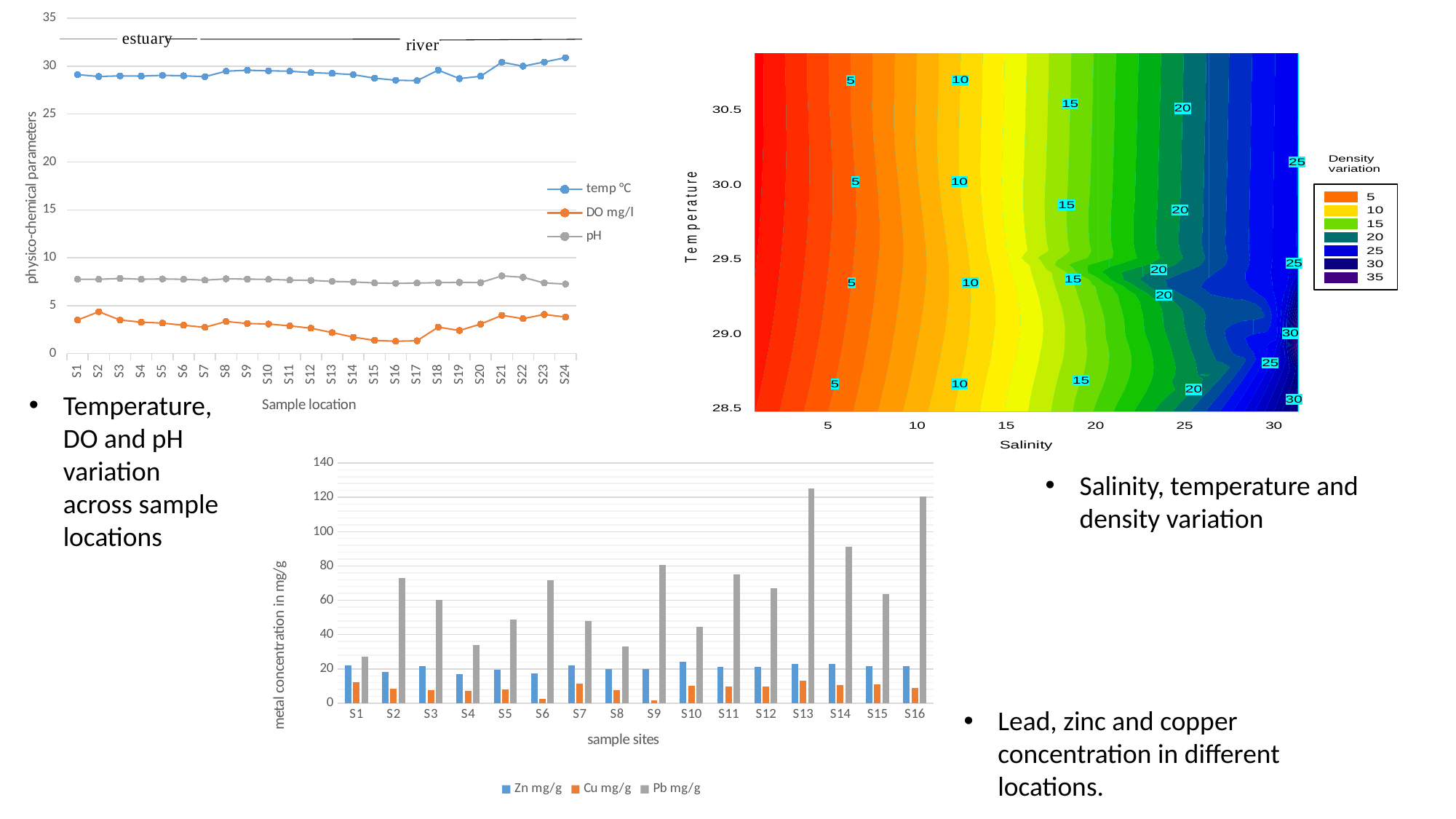
In the top-left line chart, how many sample locations are shown on the x axis? 24 In the top-left line chart, how many series does the legend list? 3 In the top-left line chart, is the temp °C value at S24 greater or less than 30? greater In the top-left line chart, is the DO mg/l value at S16 greater or less than 5? less What kind of chart is the top-left chart showing temperature, DO and pH across sample locations? line chart In the bottom bar chart, which sample site has the lowest Pb mg/g value? S1 What kind of chart is the bottom chart showing metal concentration in mg/g at sample sites? bar chart In the bottom bar chart, which is larger, the Pb mg/g value at S9 or at S10? S9 In the top-left line chart, does the DO mg/l series rise or fall from S8 to S16? fall In the top-right contour chart, how many levels does the Density variation legend list? 7 In the top-left line chart, which series has the highest values across all sample locations? temp °C In the bottom bar chart, how many sample sites are shown on the x axis? 16